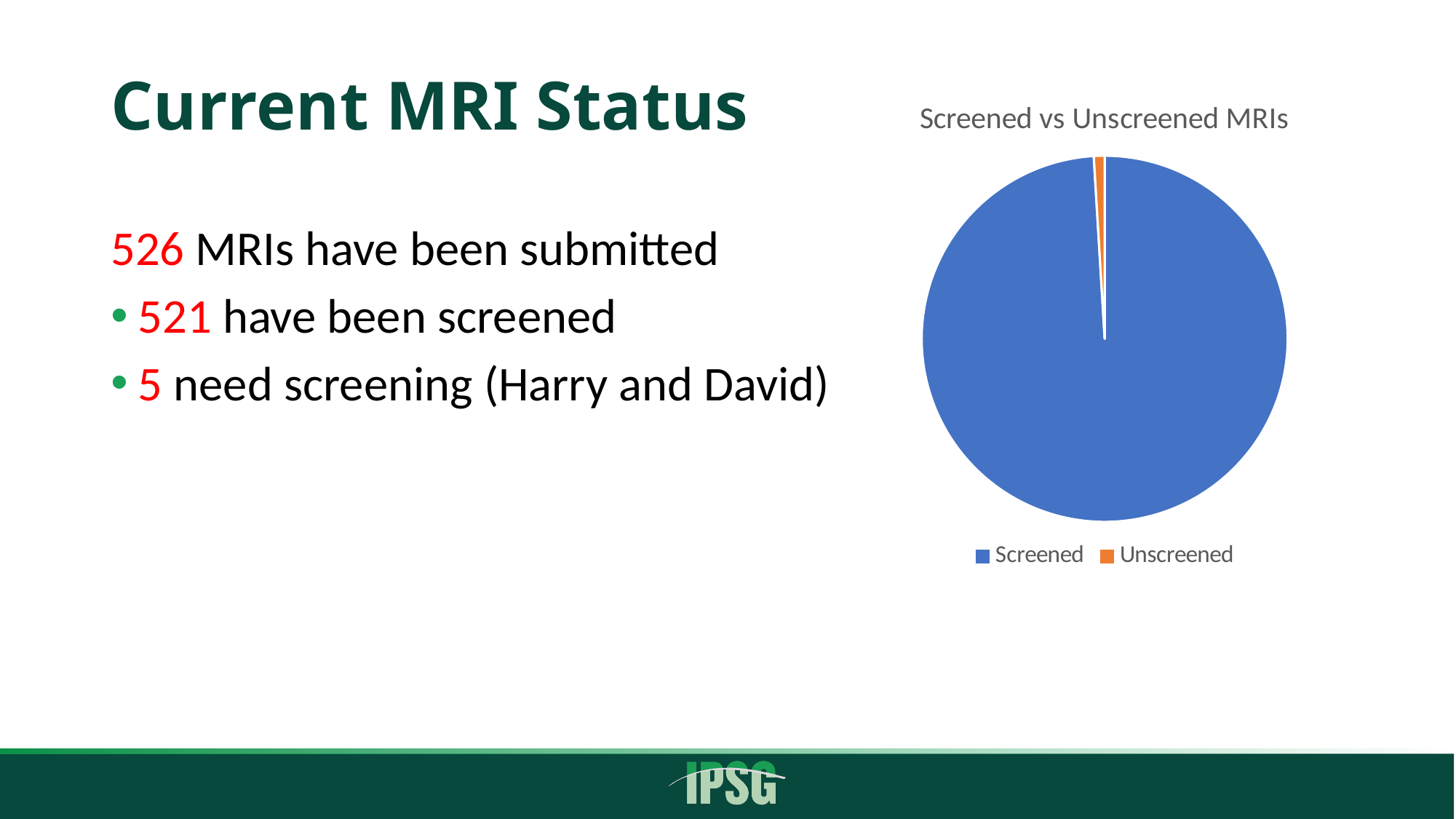
Which slice of the pie chart is the largest? Screened What is the title of the chart? Screened vs Unscreened MRIs Which slice of the pie chart is the smallest? Unscreened How many entries does the chart legend list? 2 What colour is the Unscreened slice in the pie chart? orange How many slices does the pie chart have? 2 Which is larger in the pie chart, Screened or Unscreened? Screened What kind of chart is shown on the slide? pie chart